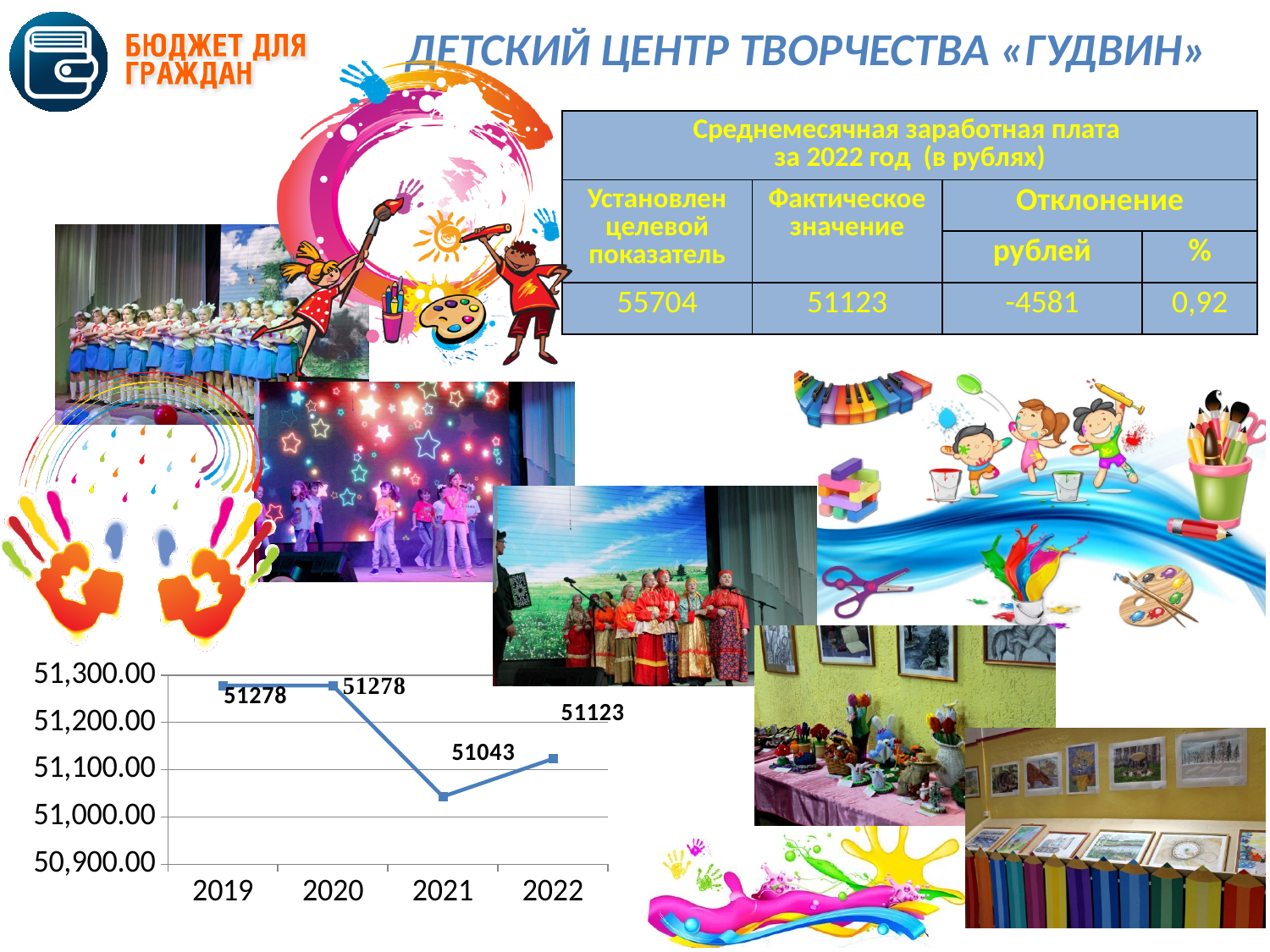
What is the difference between the values for 2020 and 2021 on the line chart? 235 Which year has the lowest value on the line chart? 2021 What is the value for 2019 on the line chart? 51278 What is the difference between the values for 2022 and 2021 on the line chart? 80 What kind of chart is shown at the bottom left of the slide? line chart Does the value on the line chart rise or fall from 2020 to 2021? fall How many years are plotted on the line chart? 4 Is the value for 2021 on the line chart greater or less than 51,100.00? less What is the difference between the values for 2019 and 2022 on the line chart? 155 What is the value for 2022 on the line chart? 51123 Which year has the larger value on the line chart, 2021 or 2022? 2022 What is the value for 2021 on the line chart? 51043